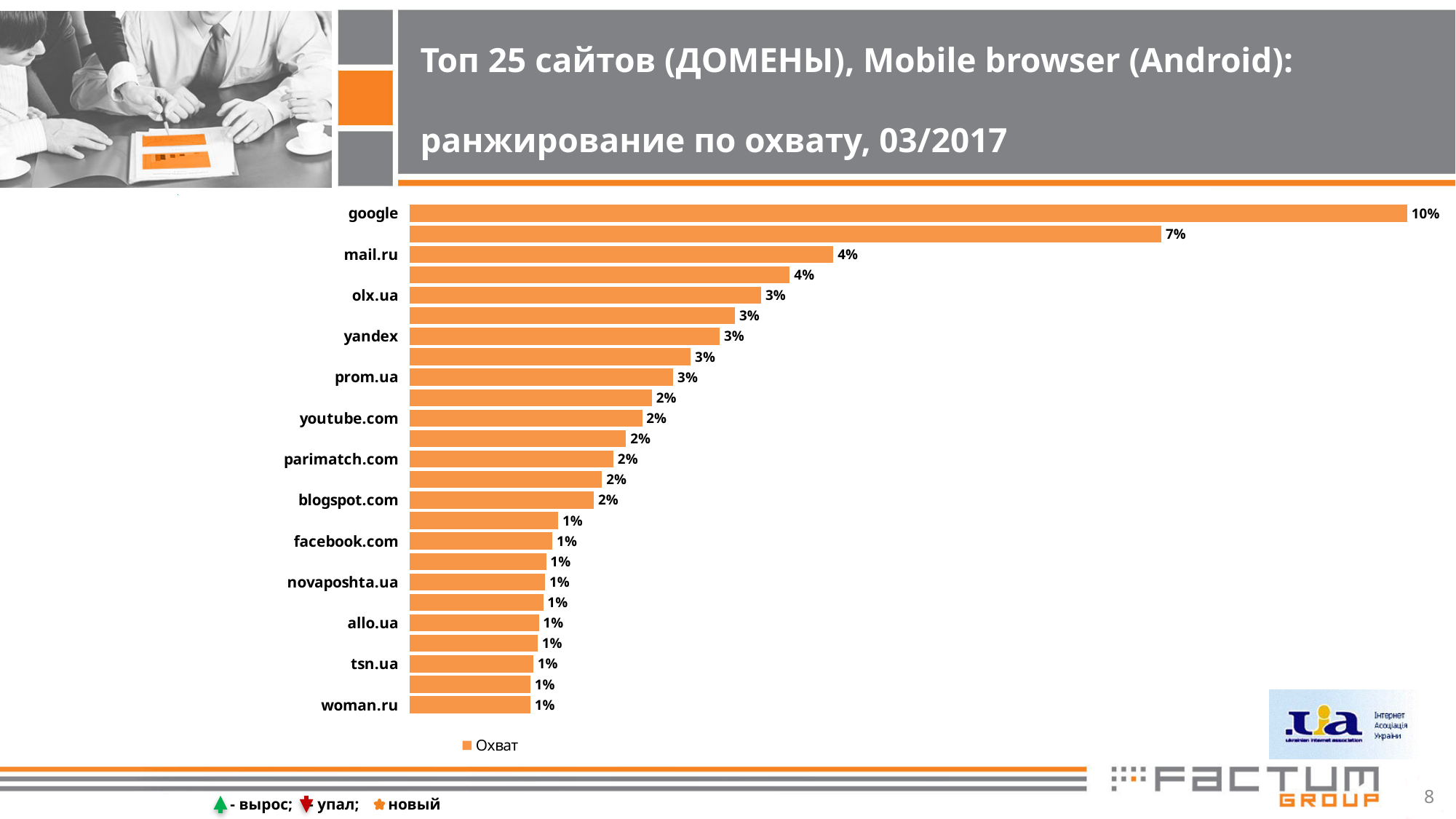
What kind of chart is shown on the slide? bar chart What is the value for facebook.com? 1% What is the value for mail.ru? 4% What is the difference between the values for google and mail.ru? 6 percentage points How many bars are plotted in the chart? 25 How many series does the legend list? 1 What is the name of the series shown in the legend? Охват Which site has the highest value? google Which is larger, the value for mail.ru or the value for youtube.com? mail.ru What is the value for youtube.com? 2% What is the value for olx.ua? 3% What is the value for google? 10%